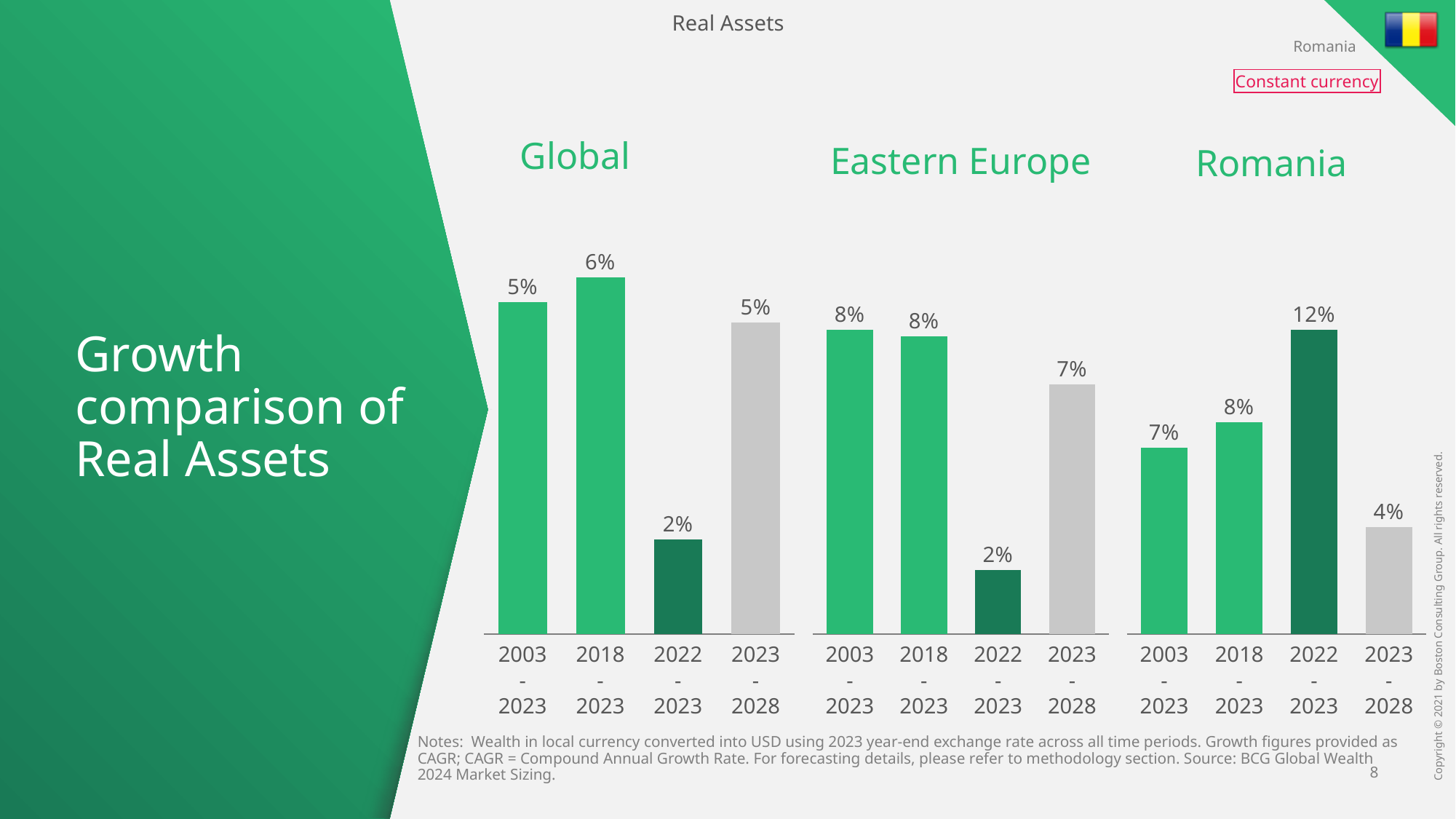
What kind of chart is the Global chart? Bar chart In the Romania chart, what is the difference between the 2022-2023 value and the 2023-2028 value? 8% In the Eastern Europe chart, which period has the lowest value? 2022-2023 How many charts are shown on the slide? 3 How many bars does the Romania chart have? 4 In the Romania chart, what is the value for 2022-2023? 12% In the Eastern Europe chart, which is larger: the value for 2003-2023 or the value for 2023-2028? 2003-2023 In the Romania chart, which period has the highest value? 2022-2023 In the Global chart, which period has the lowest value? 2022-2023 In the Eastern Europe chart, what is the value for 2023-2028? 7% In the Global chart, what is the difference between the 2018-2023 value and the 2022-2023 value? 4% In the Global chart, what is the value for 2003-2023? 5%